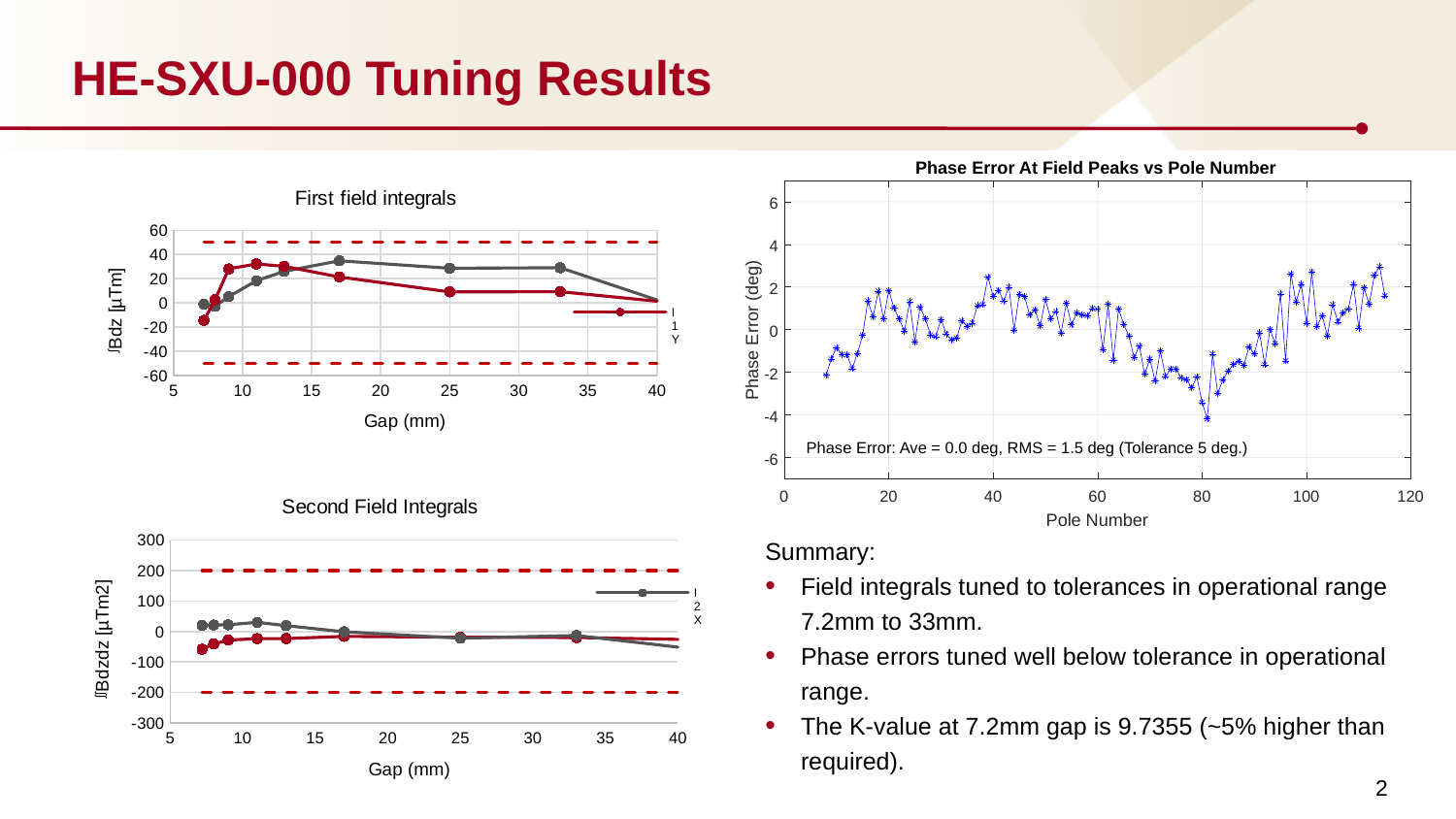
In the 'Phase Error At Field Peaks vs Pole Number' chart, what average phase error is stated in the annotation? 0.0 deg In the 'First field integrals' chart, is the grey series value at a gap of 17 mm greater or less than 20? greater What kind of chart is the 'First field integrals' chart? line chart In the 'Phase Error At Field Peaks vs Pole Number' chart, is the lowest phase error value greater or less than -2? less What kind of chart is the 'Phase Error At Field Peaks vs Pole Number' chart? line chart In the 'Phase Error At Field Peaks vs Pole Number' chart, what tolerance is stated in the annotation? 5 deg In the 'First field integrals' chart, is the upper dashed tolerance line greater or less than 40? greater In the 'Phase Error At Field Peaks vs Pole Number' chart, does the phase error generally rise or fall between pole number 60 and pole number 80? fall In the 'Phase Error At Field Peaks vs Pole Number' chart, what RMS phase error is stated in the annotation? 1.5 deg What is the x-axis label of the 'Phase Error At Field Peaks vs Pole Number' chart? Pole Number